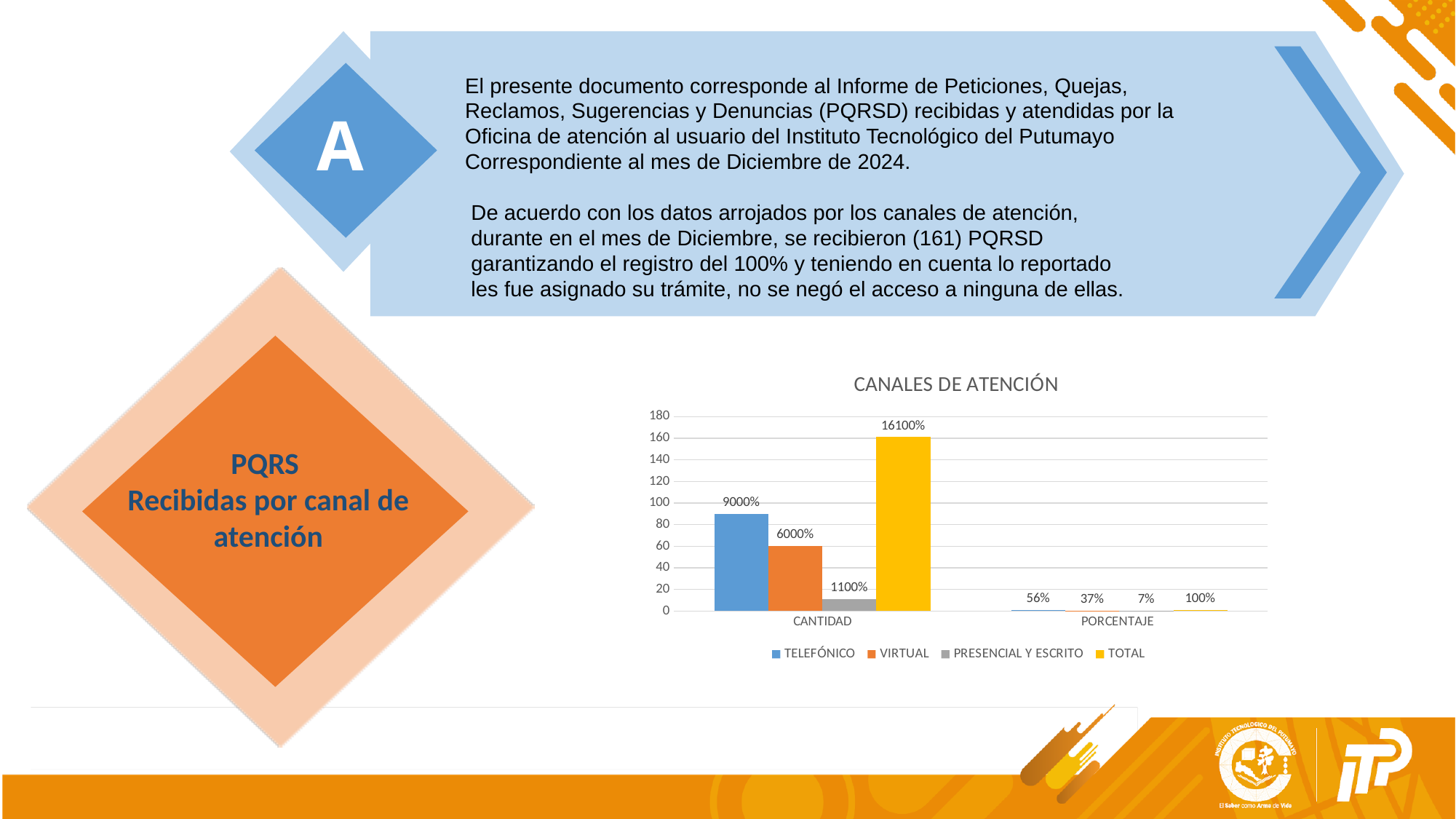
What is the data label for TOTAL in the PORCENTAJE category? 100% What is the data label for PRESENCIAL Y ESCRITO in the CANTIDAD category? 1100% In the CANTIDAD category, which bar is taller: TELEFÓNICO or VIRTUAL? TELEFÓNICO Is the TELEFÓNICO bar in the CANTIDAD category greater or less than 80 on the axis? greater In the CANTIDAD category, which series has the tallest bar? TOTAL What is the data label for TELEFÓNICO in the CANTIDAD category? 9000% What is the title of the chart on the slide? CANALES DE ATENCIÓN How many series does the legend of the CANALES DE ATENCIÓN chart list? 4 In the CANTIDAD category, which series has the shortest bar? PRESENCIAL Y ESCRITO What kind of chart is shown under the title CANALES DE ATENCIÓN? bar chart What is the data label for VIRTUAL in the PORCENTAJE category? 37% How many categories are shown on the x axis of the CANALES DE ATENCIÓN chart? 2